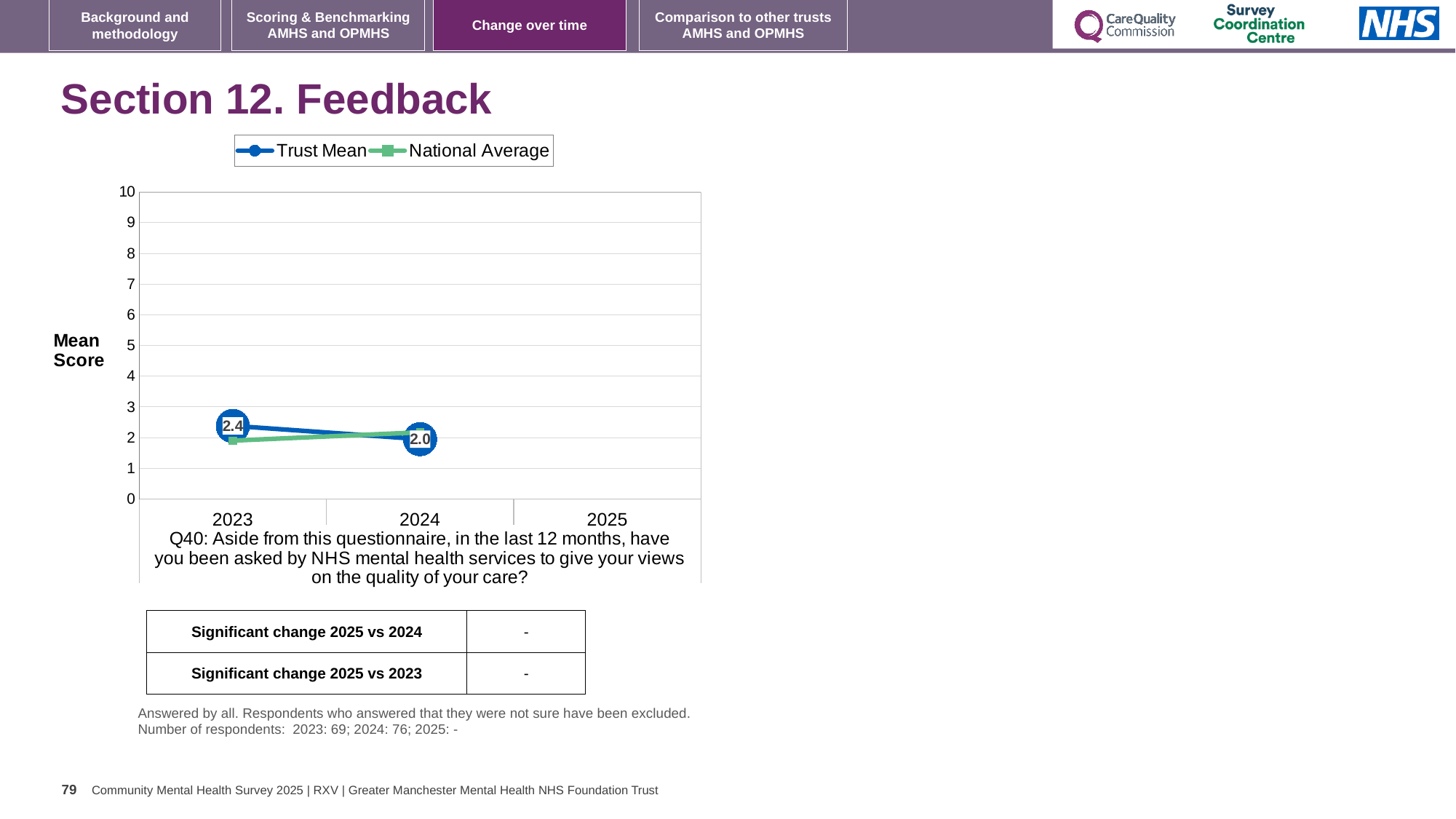
What are the two series named in the legend? Trust Mean and National Average What is the Trust Mean value for 2023? 2.4 Is the Trust Mean value for 2023 greater or less than 3? less How many series does the legend list? 2 Does the Trust Mean rise or fall from 2023 to 2024? fall Which year has the higher Trust Mean, 2023 or 2024? 2023 How many years are shown on the x axis? 3 What is the label on the y axis? Mean Score What is the Trust Mean value for 2024? 2.0 What kind of chart is shown on the slide? line chart By how much did the Trust Mean change from 2023 to 2024? 0.4 In which year is the Trust Mean highest? 2023